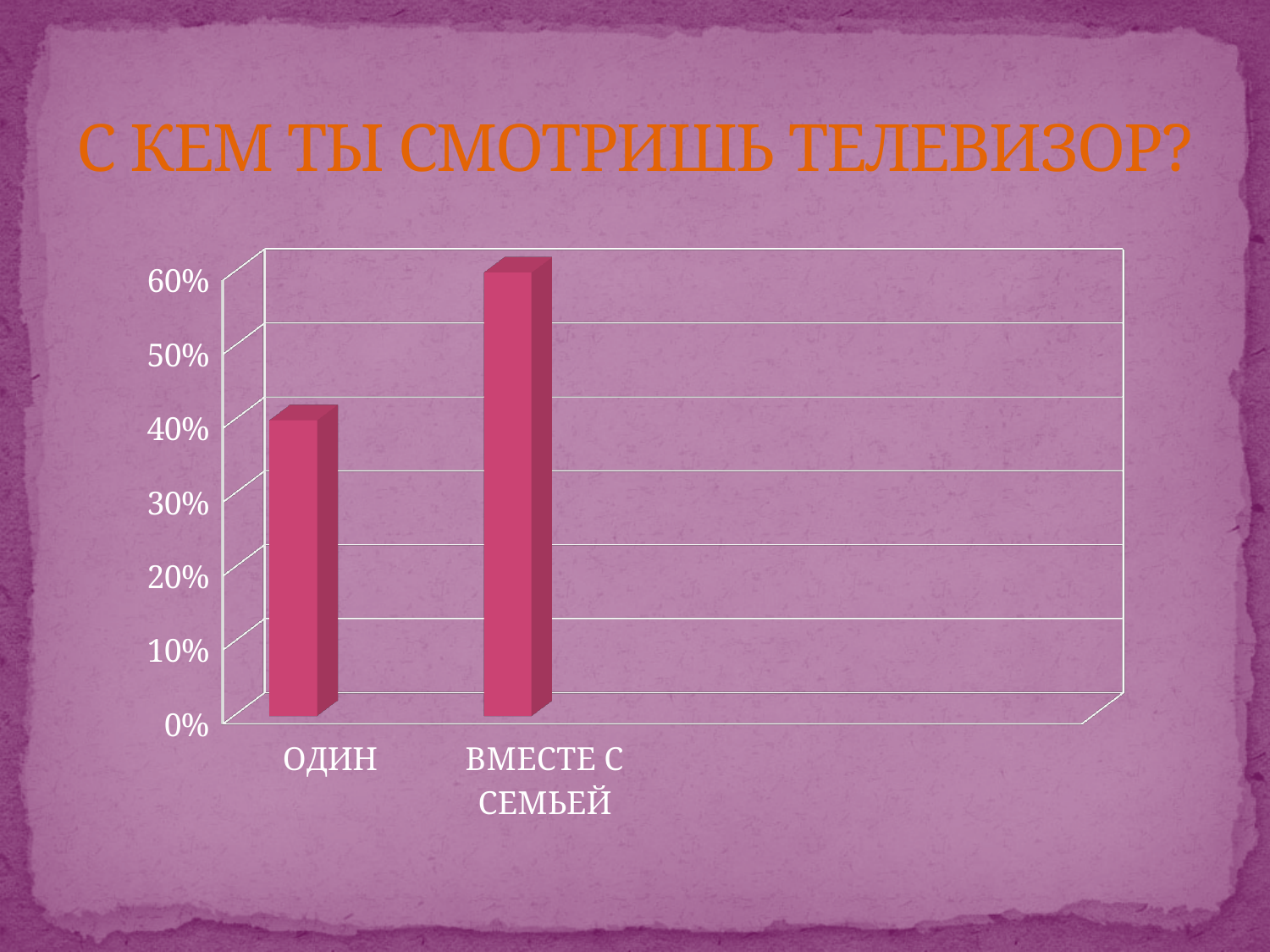
Is the value for ВМЕСТЕ С СЕМЬЕЙ greater or less than 50%? greater Which category has the lowest value in the chart? ОДИН What value does the bar for ОДИН reach on the y axis? 40% Is the value for ОДИН greater or less than 50%? less What is the title of the chart on the slide? С КЕМ ТЫ СМОТРИШЬ ТЕЛЕВИЗОР? What type of chart is shown on the slide? Bar chart Is the value for ОДИН greater or less than 30%? greater Which category has the highest value in the chart? ВМЕСТЕ С СЕМЬЕЙ How many categories are shown on the x axis of the chart? 2 Which is larger, the value for ОДИН or the value for ВМЕСТЕ С СЕМЬЕЙ? ВМЕСТЕ С СЕМЬЕЙ What is the highest value shown on the y axis of the chart? 60% What value does the bar for ВМЕСТЕ С СЕМЬЕЙ reach on the y axis? 60%